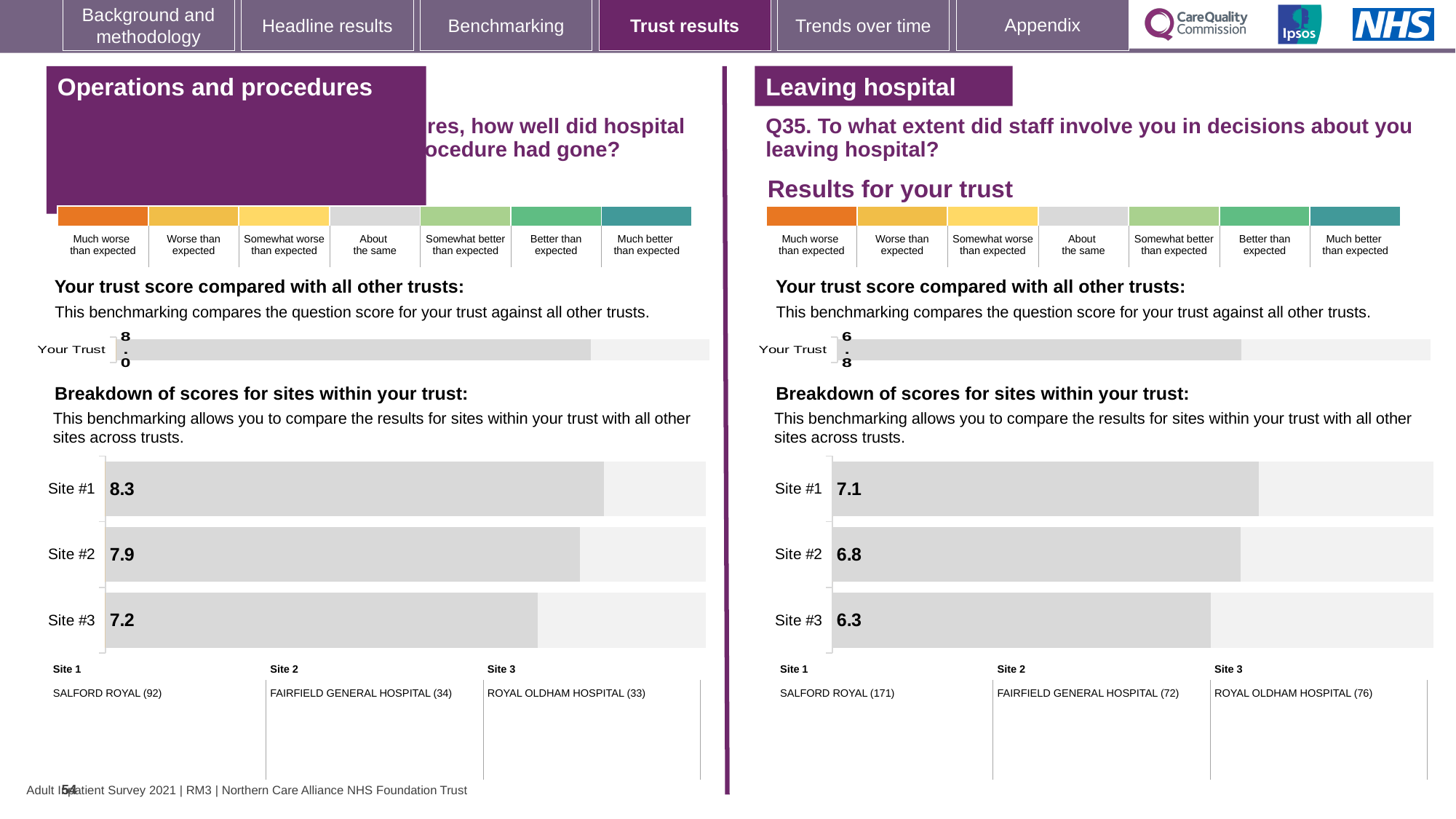
In the 'Operations and procedures' 'Your trust score' chart, what is the value shown for Your Trust? 8.0 In the 'Leaving hospital' site breakdown chart, which site has the highest score? Site #1 In the 'Leaving hospital' site breakdown chart, what is the difference between the scores for Site #1 and Site #2? 0.3 In the 'Leaving hospital' site breakdown chart, which has the larger score, Site #2 or Site #3? Site #2 What type of chart is used for the site breakdown under 'Leaving hospital'? Bar chart In the 'Leaving hospital' site breakdown chart, what is the score for Site #3? 6.3 In the 'Operations and procedures' site breakdown chart, which site has the lowest score? Site #3 In the 'Operations and procedures' site breakdown chart, do the scores rise or fall from Site #1 to Site #3? Fall In the 'Operations and procedures' site breakdown chart, what is the score for Site #1? 8.3 How many sites are shown in the 'Operations and procedures' site breakdown chart? 3 In the 'Leaving hospital' 'Your trust score' chart, what is the value shown for Your Trust? 6.8 In the 'Operations and procedures' site breakdown chart, what is the difference between the scores for Site #1 and Site #3? 1.1